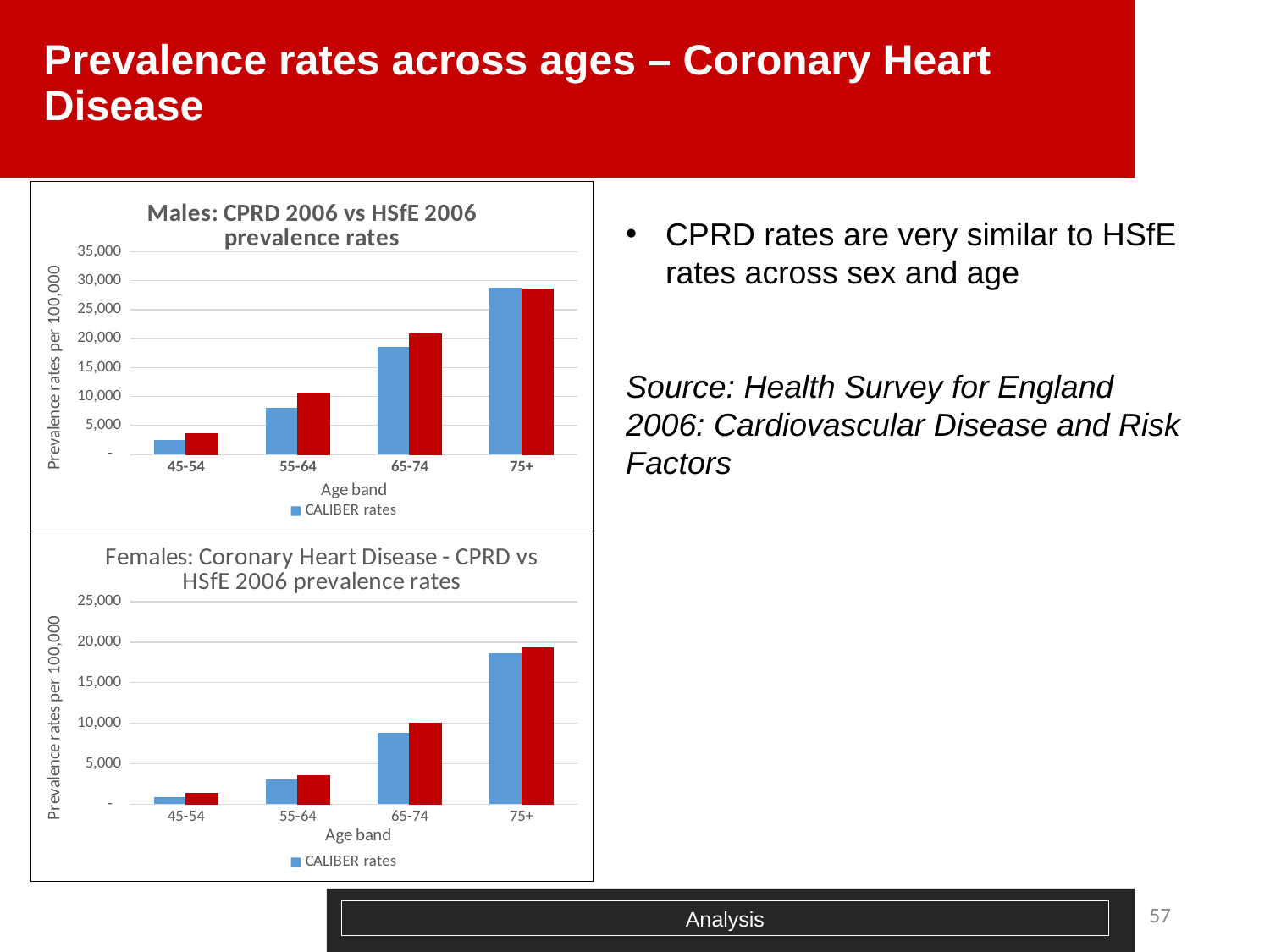
In the Males chart, do the CALIBER rates rise or fall as the age band increases? rise In the Females chart, what series name is listed in the legend? CALIBER rates In the Males chart, is the CALIBER rate for the 55-64 age band greater or less than 10,000? less In the Females chart, which age band has the lowest CALIBER rate? 45-54 In the Males chart, what kind of chart is shown? bar chart In the Females chart, how many age bands are shown on the x axis? 4 In the Females chart, which is larger, the CALIBER rate for 55-64 or for 65-74? 65-74 In the Females chart, is the CALIBER rate for the 75+ age band greater or less than 15,000? greater In the Females chart, is the CALIBER rate for the 65-74 age band greater or less than 10,000? less In the Males chart, which age band has the highest CALIBER rate? 75+ In the Males chart, what is the label on the y axis? Prevalence rates per 100,000